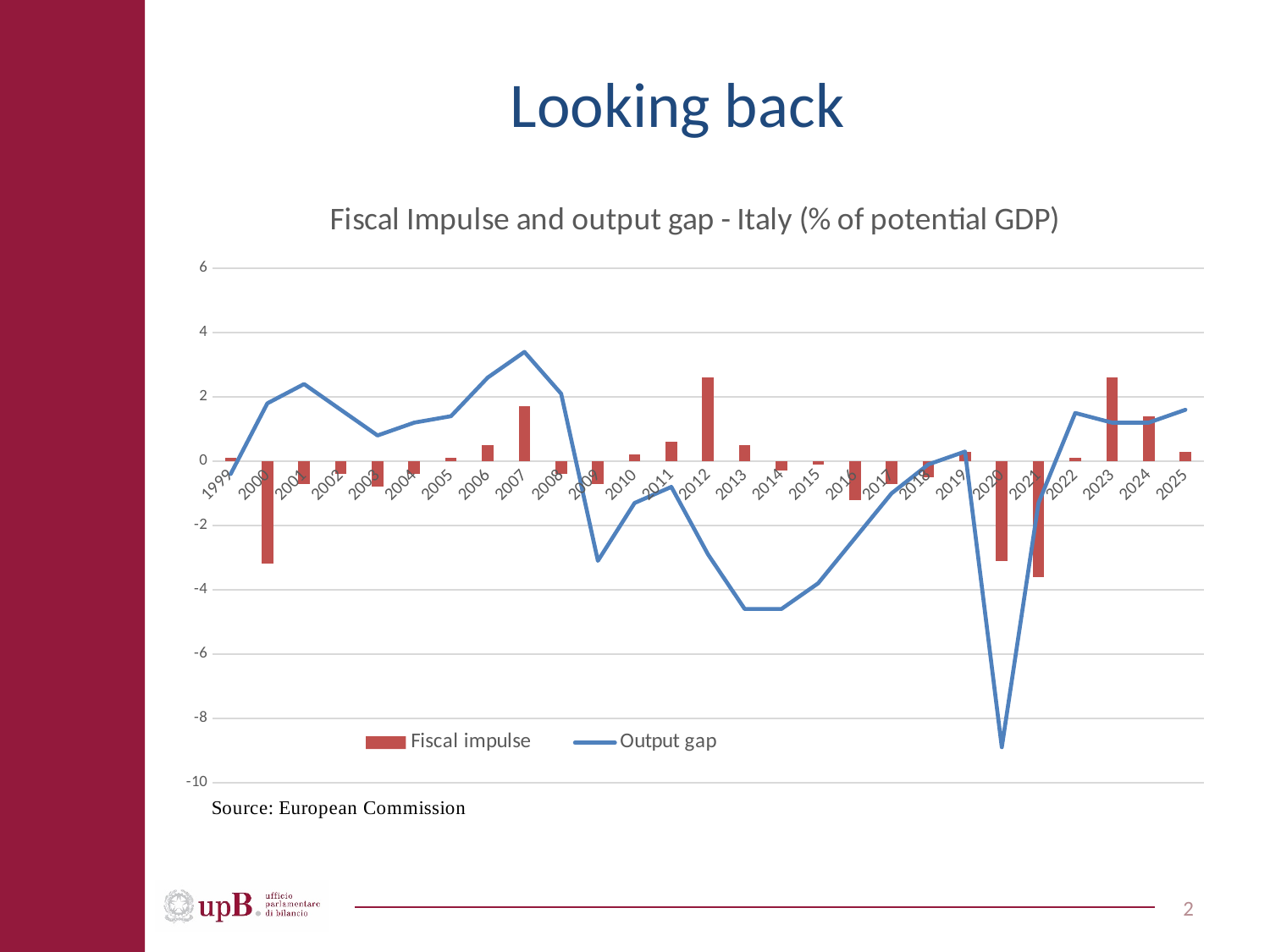
What is the title of the chart? Fiscal Impulse and output gap - Italy (% of potential GDP) How many years are shown on the x axis? 27 What kind of chart is shown on the slide? A combined bar and line chart Is the fiscal impulse for 2012 greater or less than 2? greater In which year is the fiscal impulse lowest? 2021 How many series does the legend list? 2 In which year is the output gap highest? 2007 Is the output gap for 2013 greater or less than -4? less In which year is the output gap lowest? 2020 Which series is drawn as bars? Fiscal impulse Is the output gap for 2020 greater or less than -8? less Which is larger, the output gap in 2007 or in 2009? 2007